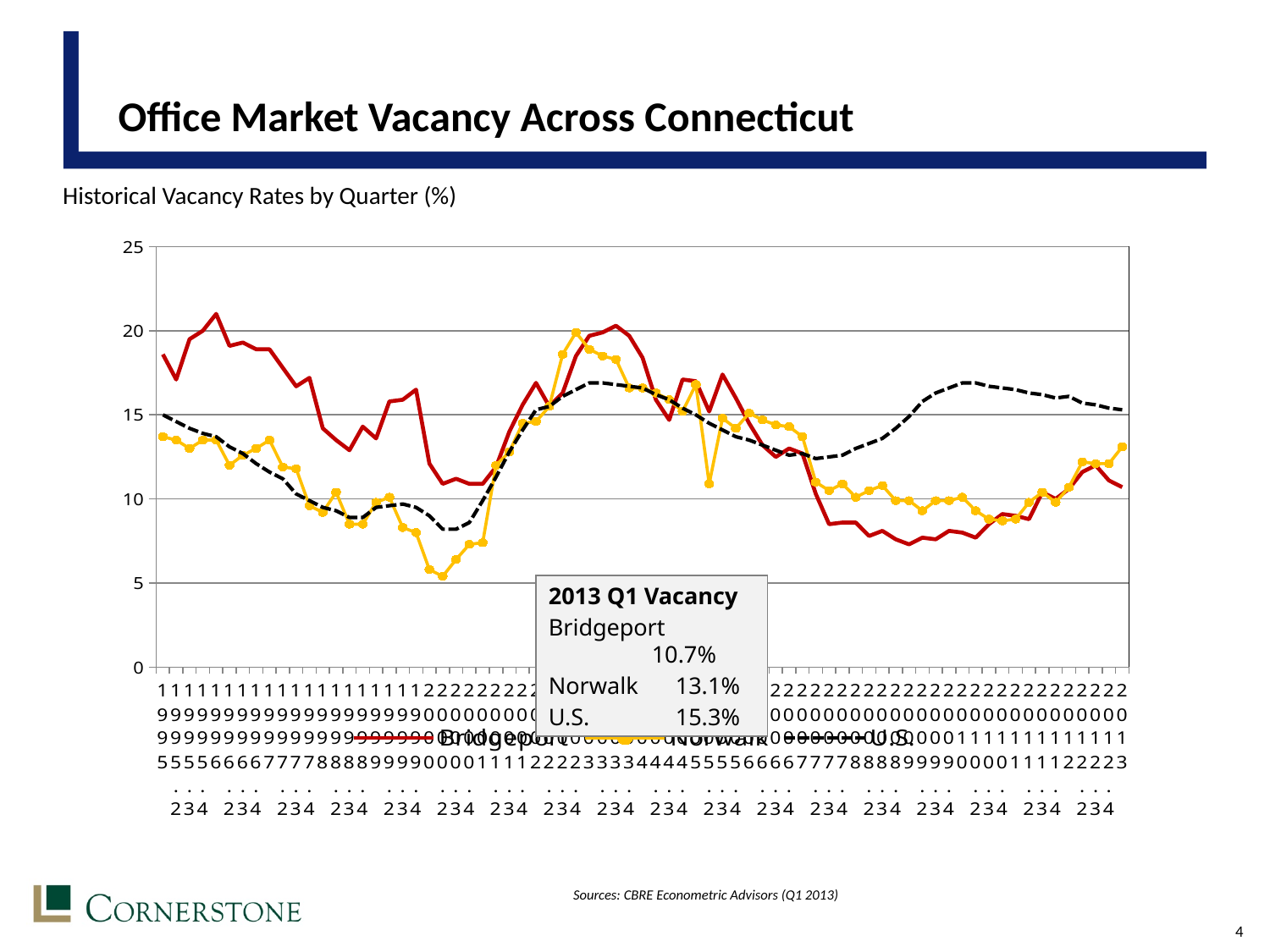
What is the subtitle shown above the chart? Historical Vacancy Rates by Quarter (%) What is the 2013 Q1 vacancy rate for Norwalk? 13.1% Which of the three series has the highest 2013 Q1 vacancy rate? U.S. Is the highest value reached by the Bridgeport line greater or less than 20? greater Which of the three series has the lowest 2013 Q1 vacancy rate? Bridgeport In 2013 Q1, is the vacancy rate higher for Norwalk or for Bridgeport? Norwalk How many series does the chart's legend list? 3 What is the difference between the Norwalk and Bridgeport 2013 Q1 vacancy rates? 2.4% What is the difference between the U.S. and Norwalk 2013 Q1 vacancy rates? 2.2% What is the 2013 Q1 vacancy rate for Bridgeport? 10.7% What kind of chart is shown on the slide? Line chart What is the 2013 Q1 vacancy rate for the U.S.? 15.3%